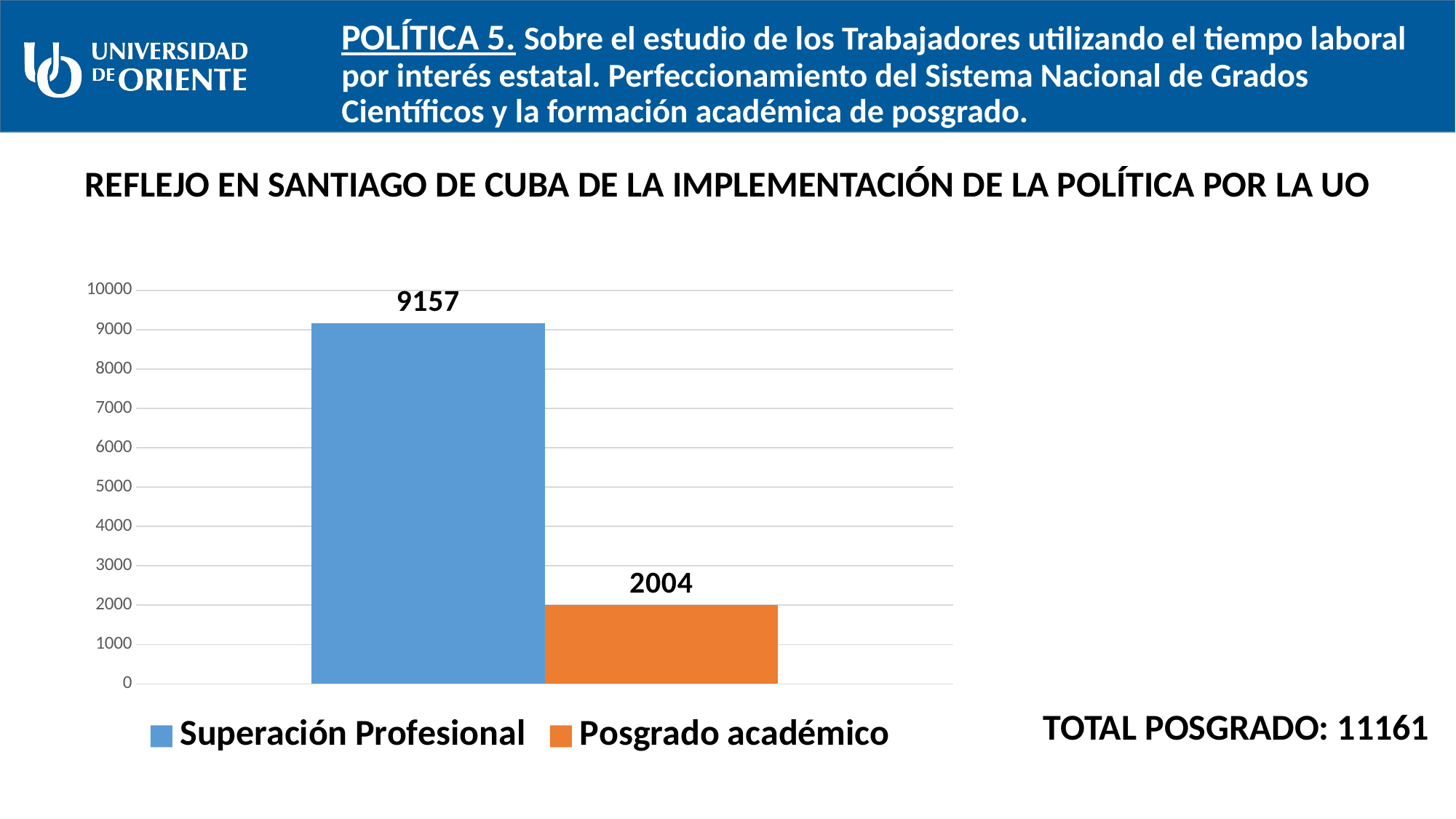
Which is larger, Superación Profesional or Posgrado académico? Superación Profesional How many series does the legend list? 2 What colour is the bar for Posgrado académico? orange What is the total of the two plotted values? 11161 What is the difference between the values for Superación Profesional and Posgrado académico? 7153 What kind of chart is shown on the slide? bar chart Which series has the highest value? Superación Profesional Which series has the lowest value? Posgrado académico What is the value for Superación Profesional? 9157 Is the value for Superación Profesional greater or less than 9000? greater What is the value for Posgrado académico? 2004 Is the value for Posgrado académico greater or less than 3000? less